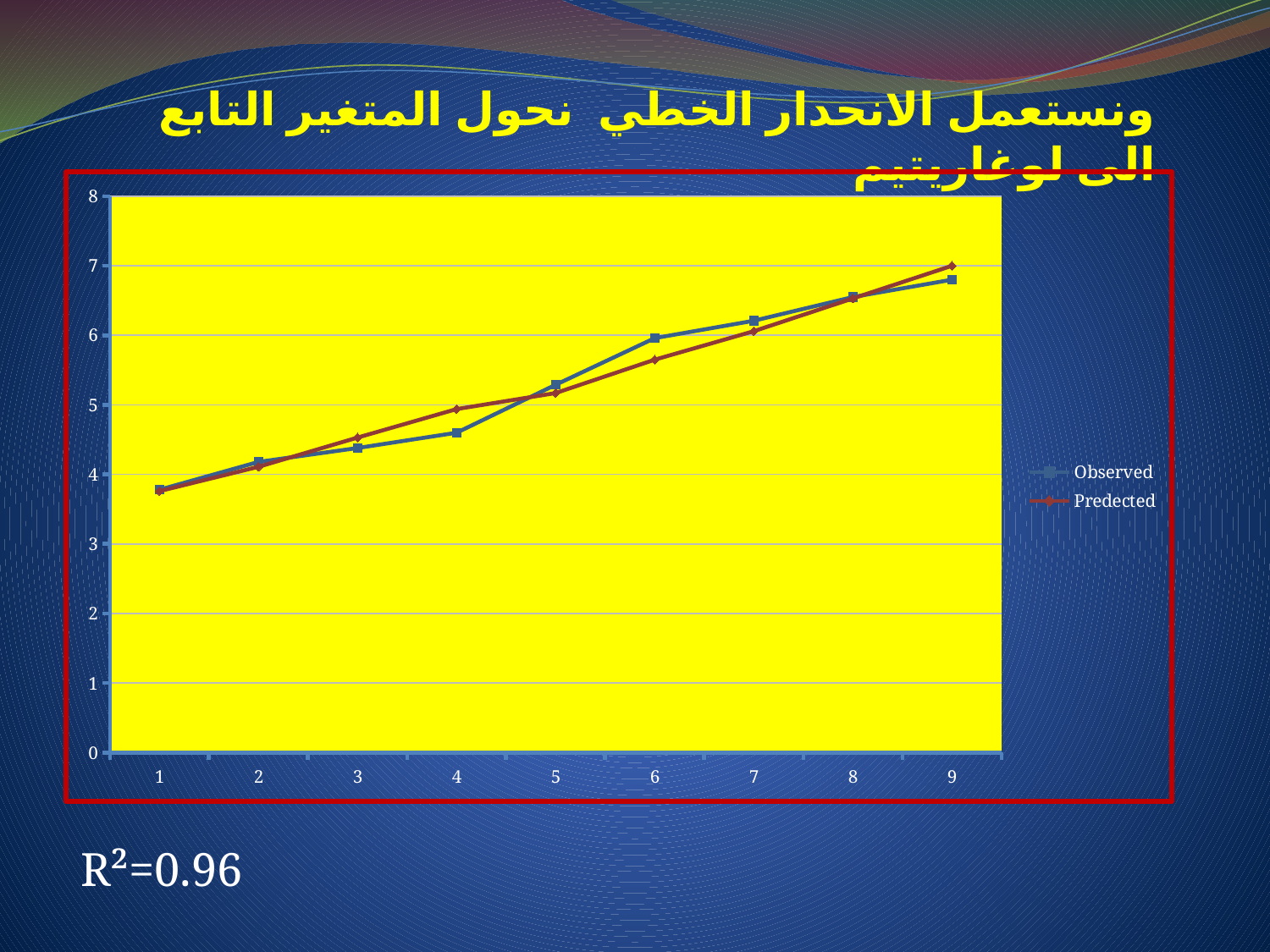
At which x value is the Observed series highest? 9 At x = 6, which series has the larger value, Observed or Predected? Observed Do the Observed values rise or fall as the x axis goes from 1 to 9? rise What are the names of the two series in the legend? Observed and Predected What kind of chart is shown on the slide? line chart At x = 4, which series has the larger value, Observed or Predected? Predected How many points are plotted along the x axis for each series? 9 Is the Observed value at x = 1 greater or less than 4? less Is the Predected value at x = 6 greater or less than 5? greater Is the Observed value at x = 9 greater or less than 6? greater How many series does the legend list? 2 At which x value is the Predected series lowest? 1